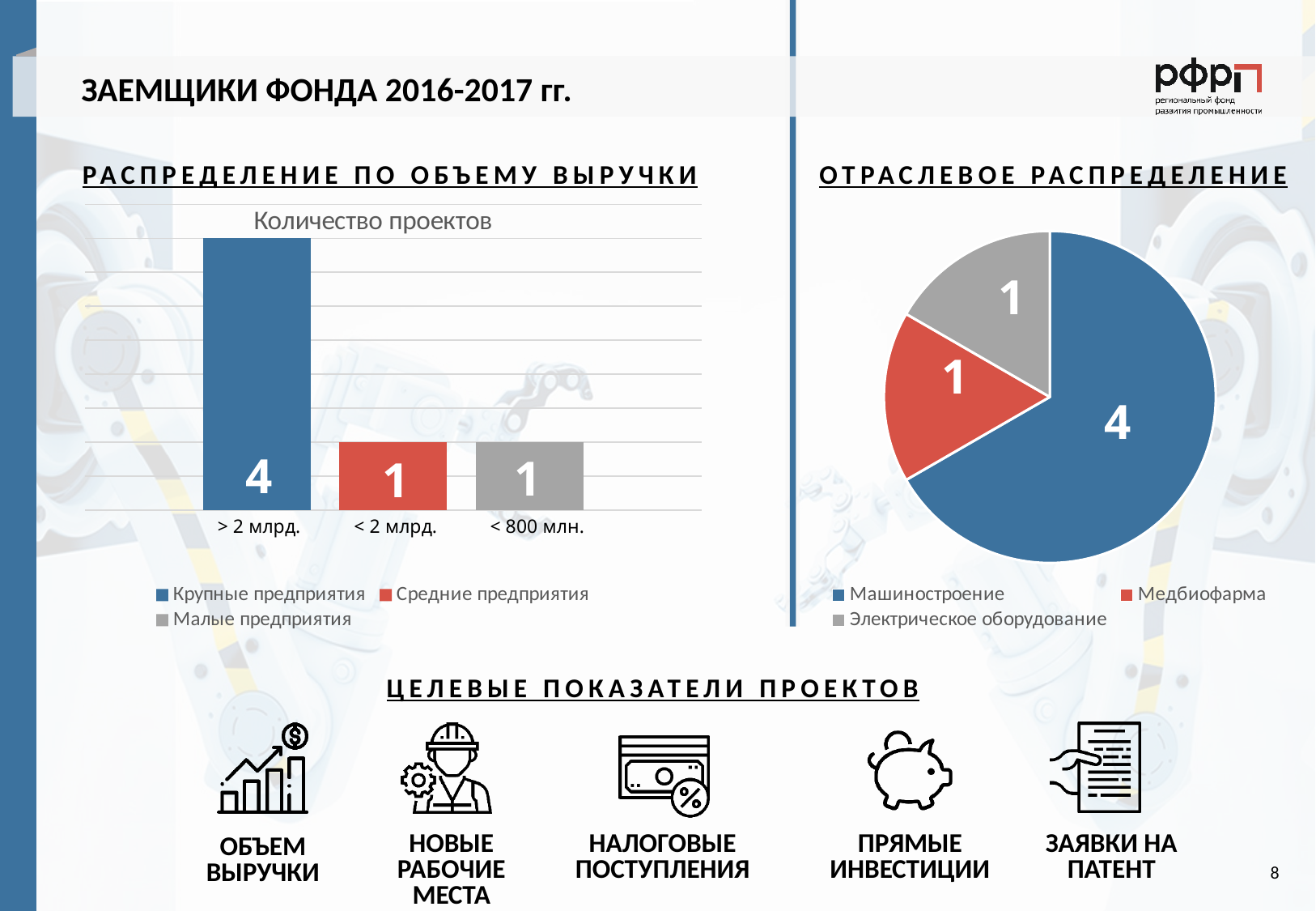
In the left chart 'Количество проектов', which category has the highest value? > 2 млрд. In the right pie chart 'Отраслевое распределение', what is the value for 'Медбиофарма'? 1 In the right pie chart 'Отраслевое распределение', which sector has the largest slice? Машиностроение What type of chart is the left chart 'Количество проектов'? bar chart In the left chart 'Количество проектов', what is the difference between the values for '> 2 млрд.' and '< 2 млрд.'? 3 In the left chart 'Количество проектов', what is the value for '> 2 млрд.'? 4 In the right pie chart 'Отраслевое распределение', is the value for 'Машиностроение' larger or smaller than the value for 'Электрическое оборудование'? larger In the right pie chart 'Отраслевое распределение', what is the value for 'Машиностроение'? 4 In the left chart 'Количество проектов', what is the value for '< 800 млн.'? 1 In the right pie chart 'Отраслевое распределение', what colour is the 'Медбиофарма' slice? red In the left chart 'Количество проектов', how many entries does the legend list? 3 In the left chart 'Количество проектов', how many categories are shown on the x axis? 3